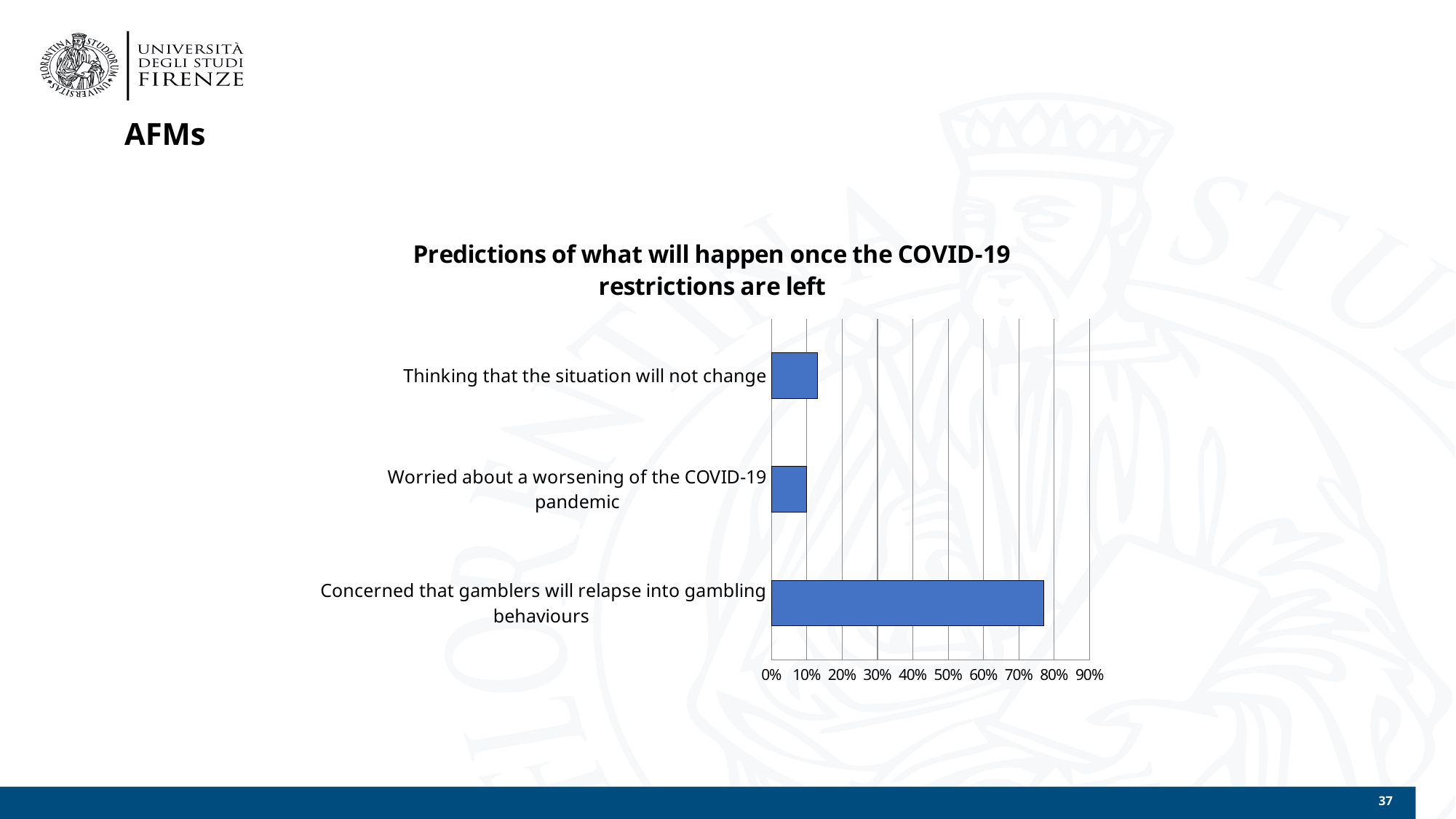
Which category has the highest value? Concerned that gamblers will relapse into gambling behaviours What is the highest value shown on the horizontal axis of the chart? 90% Is the value for 'Thinking that the situation will not change' greater or less than 20%? less What is the title of the chart? Predictions of what will happen once the COVID-19 restrictions are left Which is larger: the value for 'Worried about a worsening of the COVID-19 pandemic' or the value for 'Concerned that gamblers will relapse into gambling behaviours'? Concerned that gamblers will relapse into gambling behaviours How many categories are plotted in the chart? 3 Is the value for 'Concerned that gamblers will relapse into gambling behaviours' greater or less than 80%? less Is the value for 'Worried about a worsening of the COVID-19 pandemic' greater or less than 20%? less What kind of chart is shown on the slide? bar chart Which is larger: the value for 'Concerned that gamblers will relapse into gambling behaviours' or the value for 'Thinking that the situation will not change'? Concerned that gamblers will relapse into gambling behaviours